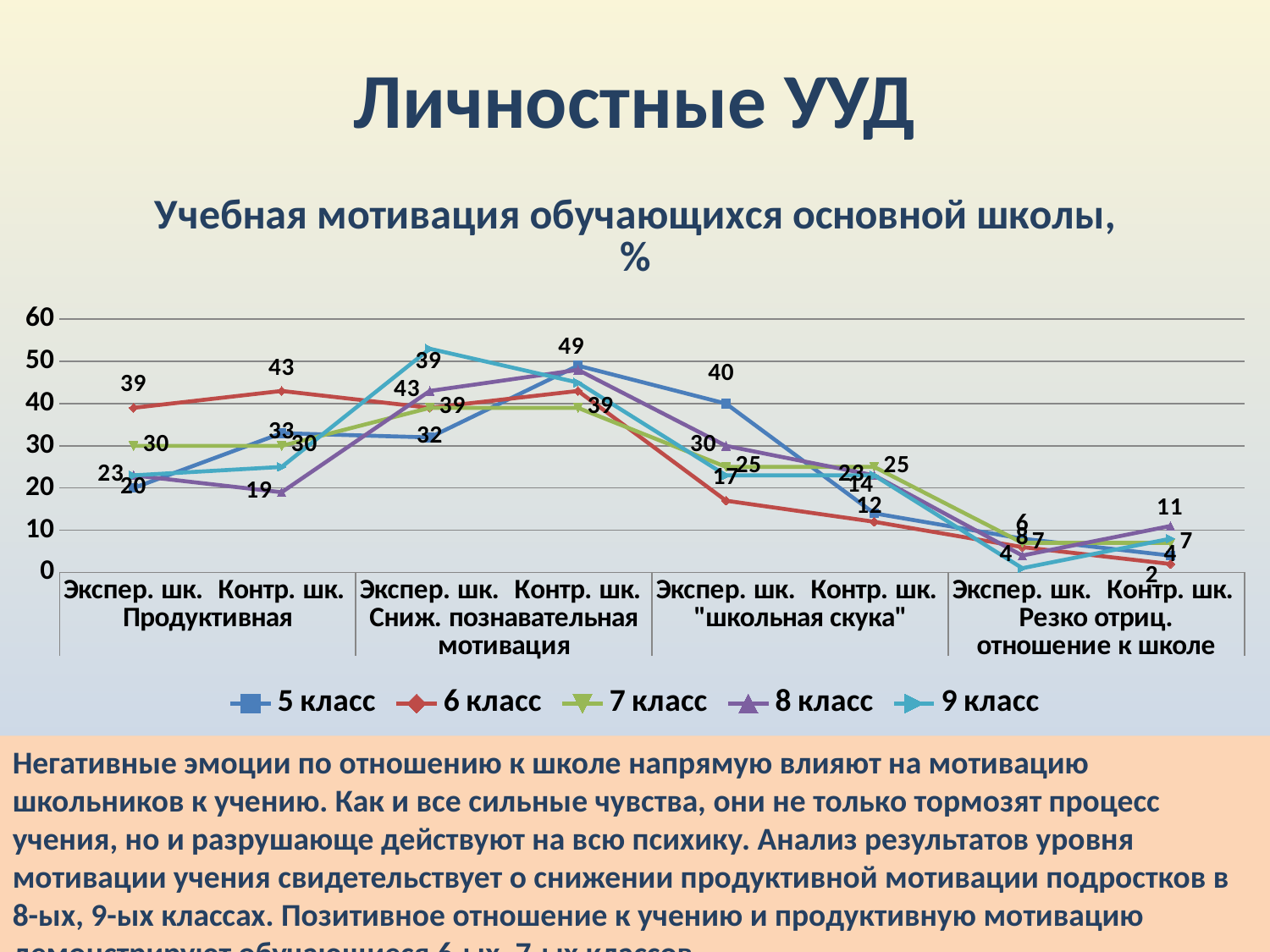
How many categories are plotted along the x axis? 8 At which category does 6 класс have its lowest value? Контр. шк. Резко отриц. отношение к школе What is the value for 8 класс at Контр. шк. Продуктивная? 19 Is the value for 6 класс at Контр. шк. Резко отриц. отношение к школе greater or less than 10? less What is the value for 5 класс at Контр. шк. Сниж. познавательная мотивация? 49 What is the difference between the 6 класс values at Контр. шк. Продуктивная and Экспер. шк. Продуктивная? 4 What kind of chart is shown on the slide? line chart At which category does 5 класс reach its highest value? Контр. шк. Сниж. познавательная мотивация What is the value for 6 класс at Экспер. шк. Продуктивная? 39 How many series does the legend list? 5 What is the title of the chart? Учебная мотивация обучающихся основной школы, % Which series is drawn in red? 6 класс